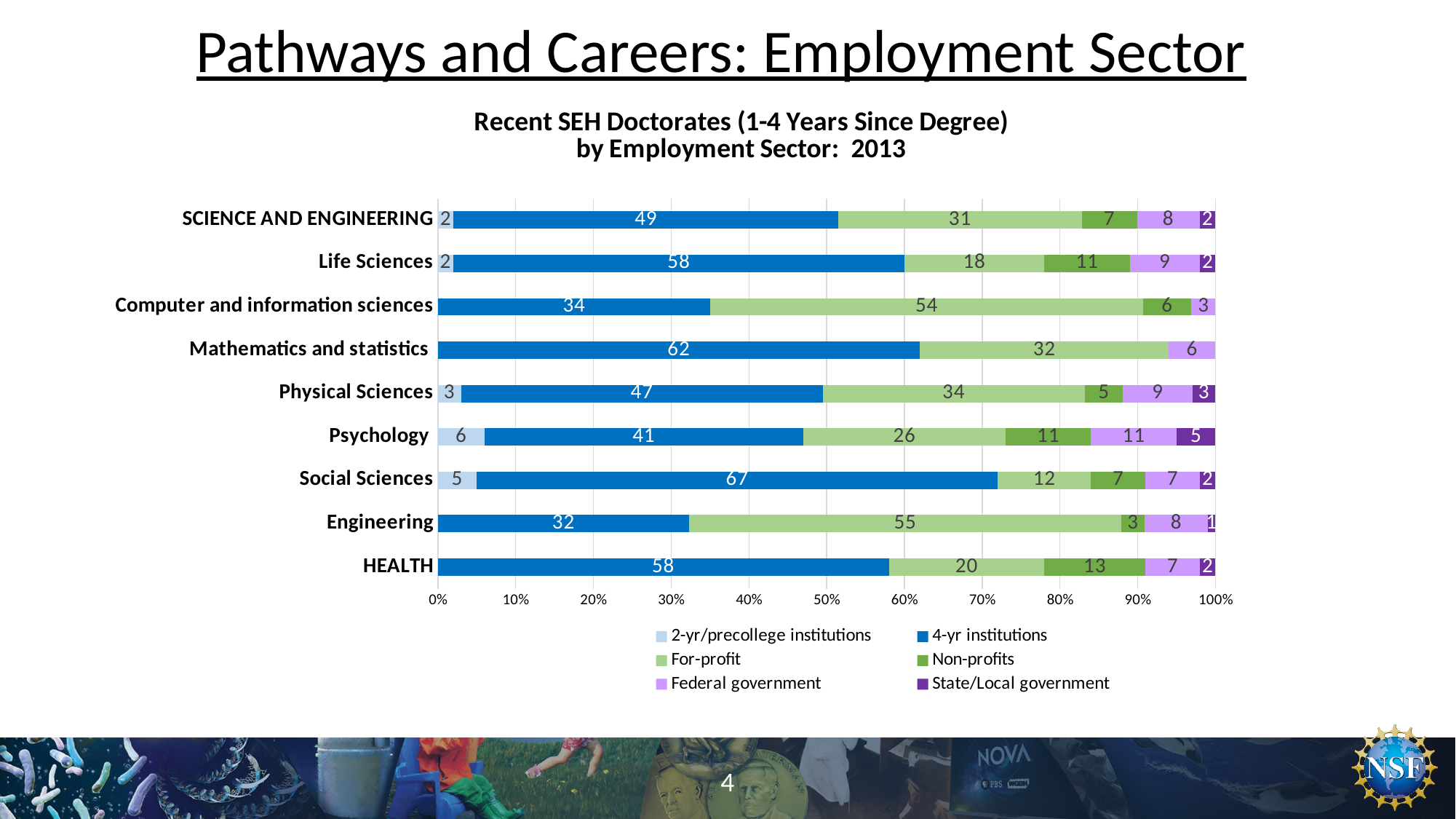
How many categories (fields) are plotted on the chart? 9 What is the 4-yr institutions value for Social Sciences? 67 What is the Federal government value for Psychology? 11 Which field has the lowest 4-yr institutions value? Engineering Which field has the highest 4-yr institutions value? Social Sciences What year does the chart title say the data is for? 2013 How many series does the legend list? 6 Which is larger: the 4-yr institutions value for Mathematics and statistics or for Physical Sciences? Mathematics and statistics What is the difference between the For-profit values for Engineering and Life Sciences? 37 What kind of chart is shown on the slide? stacked bar chart What is the Non-profits value for HEALTH? 13 What is the For-profit value for Computer and information sciences? 54